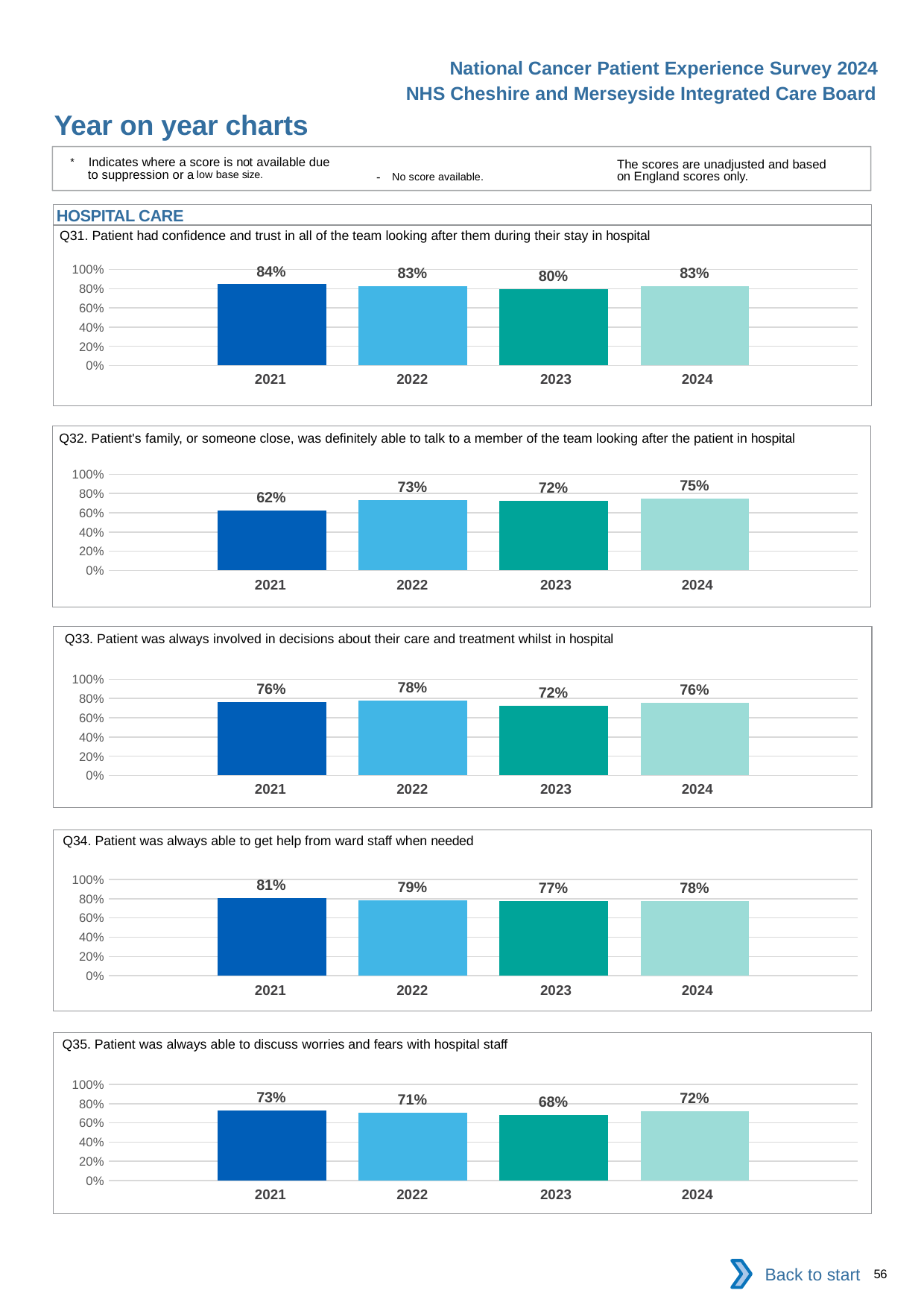
What kind of chart is the Q34 chart (patient was always able to get help from ward staff)? bar chart In the Q32 chart (patient's family was definitely able to talk to a member of the team), which year has the lowest value? 2021 In the Q34 chart (patient was always able to get help from ward staff), what is the value for 2024? 78% In the Q31 chart (patient had confidence and trust in all of the team), is the value for 2023 greater or less than 60%? greater In the Q35 chart (patient was always able to discuss worries and fears), which year has the lowest value? 2023 In the Q35 chart (patient was always able to discuss worries and fears), what is the difference between the 2021 and 2023 values? 5% In the Q32 chart (patient's family was definitely able to talk to a member of the team), what is the difference between the 2024 and 2021 values? 13% In the Q31 chart (patient had confidence and trust in all of the team), what is the value for 2021? 84% In the Q33 chart (patient was always involved in decisions about their care), what is the value for 2023? 72% In the Q34 chart (patient was always able to get help from ward staff), is the value for 2023 larger or smaller than the value for 2021? smaller In the Q33 chart (patient was always involved in decisions about their care), which year has the highest value? 2022 How many years are shown on the x axis of the Q31 chart (patient had confidence and trust in all of the team)? 4